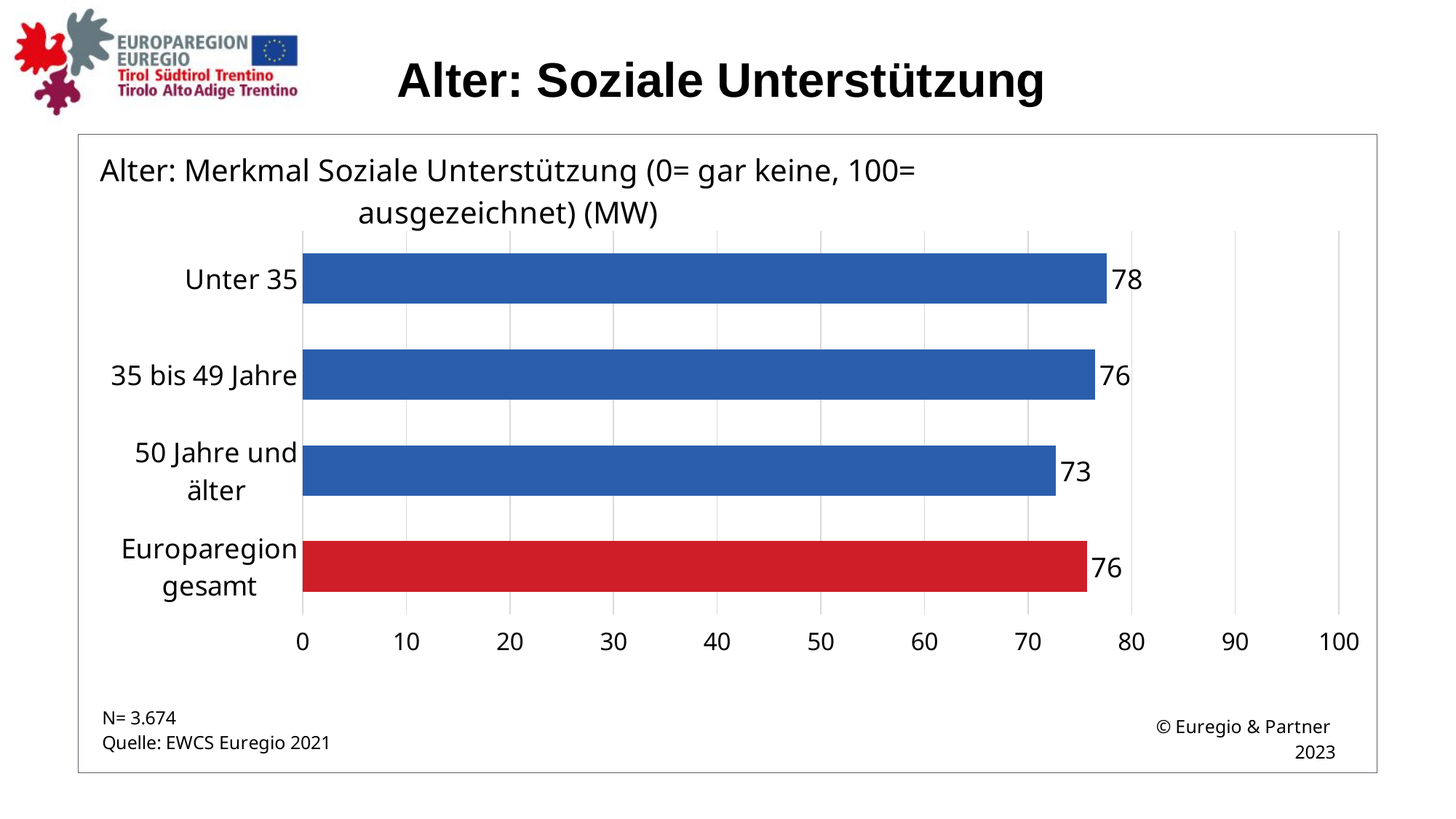
What is the value for Europaregion gesamt? 76 Which is larger, the value for Unter 35 or the value for 50 Jahre und älter? Unter 35 What is the value for 35 bis 49 Jahre? 76 What is the difference between the values for Unter 35 and 50 Jahre und älter? 5 What kind of chart is shown on the slide? bar chart How many categories are shown in the chart? 4 Is the value for 50 Jahre und älter greater or less than 80? less Which category has the lowest value? 50 Jahre und älter Which category has the highest value? Unter 35 What is the value for 50 Jahre und älter? 73 What is the value for Unter 35? 78 Which category's bar is coloured red? Europaregion gesamt